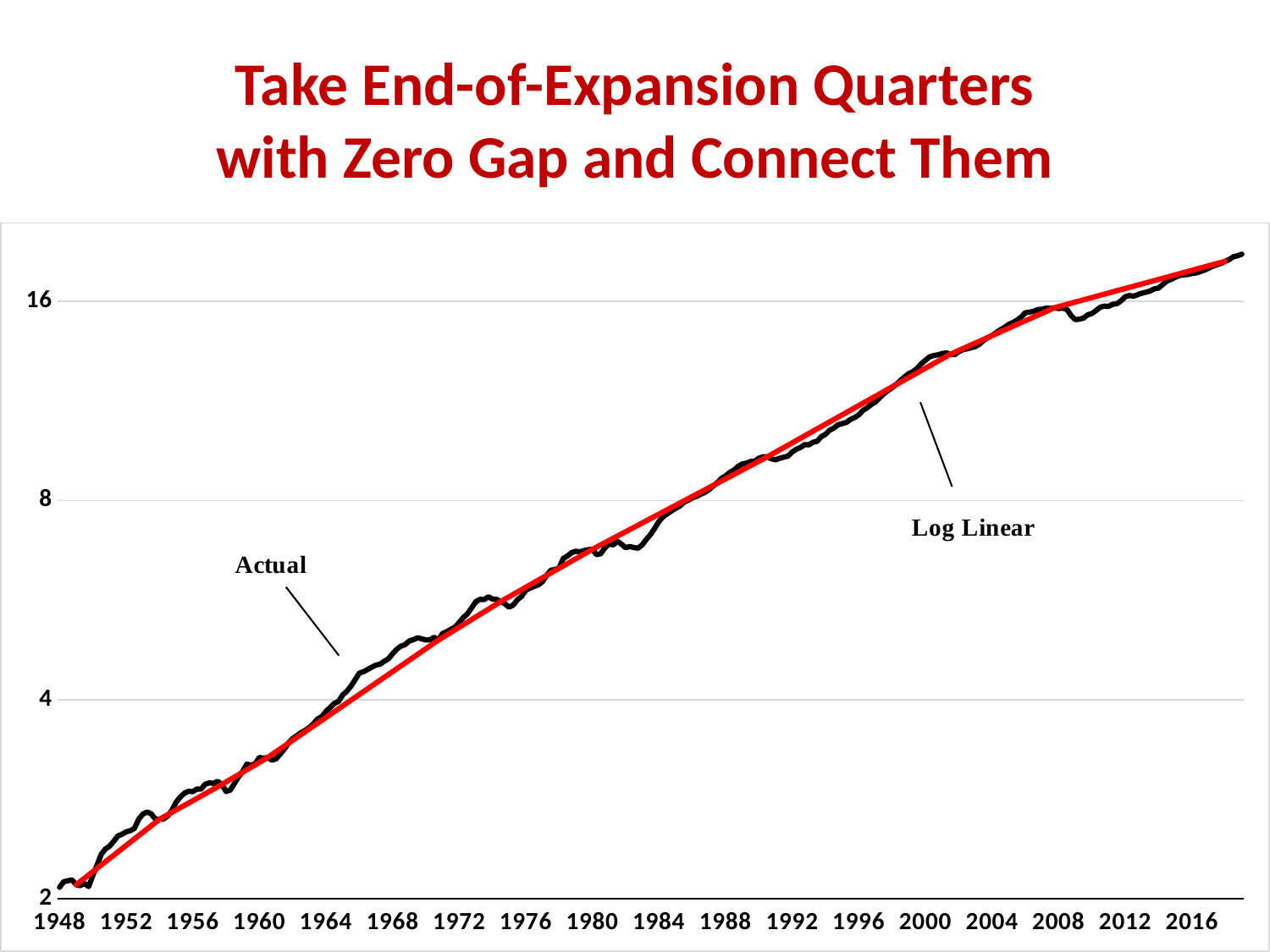
Is the value of the Actual line in 1972 greater or less than 4? greater What are the names of the two lines labelled on the chart? Actual and Log Linear Is the value of the Actual line in 1956 greater or less than 4? less How many lines (series) are plotted on the chart? 2 Is the value of the Actual line in 1992 greater or less than 8? greater How many year labels are shown on the x axis? 18 What kind of chart is shown on the slide? line chart What is the title of the slide? Take End-of-Expansion Quarters with Zero Gap and Connect Them Does the Actual line generally rise or fall from 1948 to 2016? rise Does the Log Linear line rise or fall along the x axis? rise